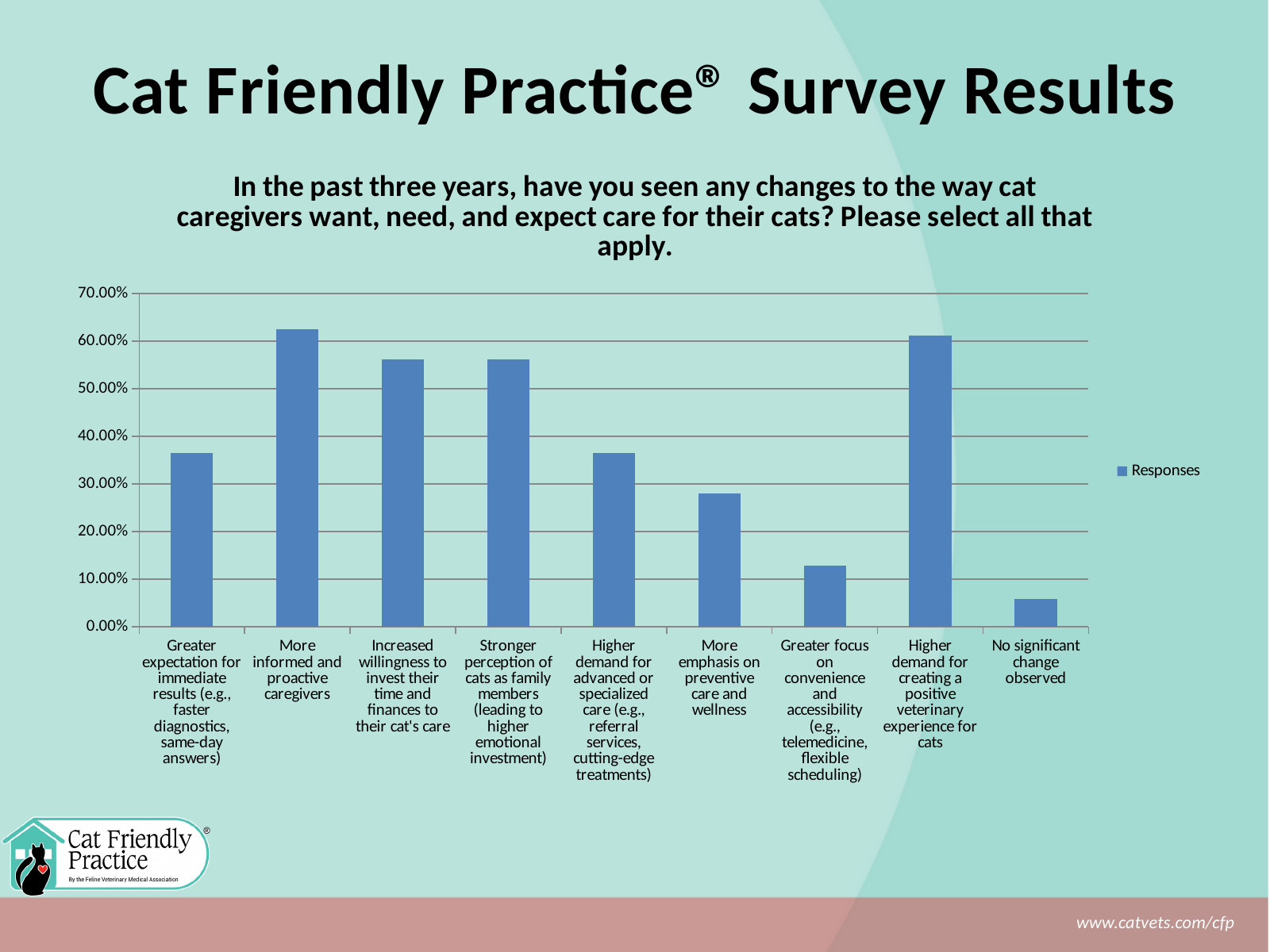
Which category has the lowest value in the chart? No significant change observed What kind of chart is shown on the slide? bar chart Is the value for 'No significant change observed' greater or less than 10.00%? less Is the value for 'Higher demand for creating a positive veterinary experience for cats' greater or less than 50.00%? greater Is the value for 'Greater expectation for immediate results' greater or less than 40.00%? less Which has a larger value: 'Increased willingness to invest their time and finances to their cat's care' or 'More emphasis on preventive care and wellness'? Increased willingness to invest their time and finances to their cat's care Which has a larger value: 'Greater focus on convenience and accessibility' or 'No significant change observed'? Greater focus on convenience and accessibility How many series does the chart legend list? 1 What is the name of the series shown in the chart legend? Responses How many response categories are shown on the x axis of the chart? 9